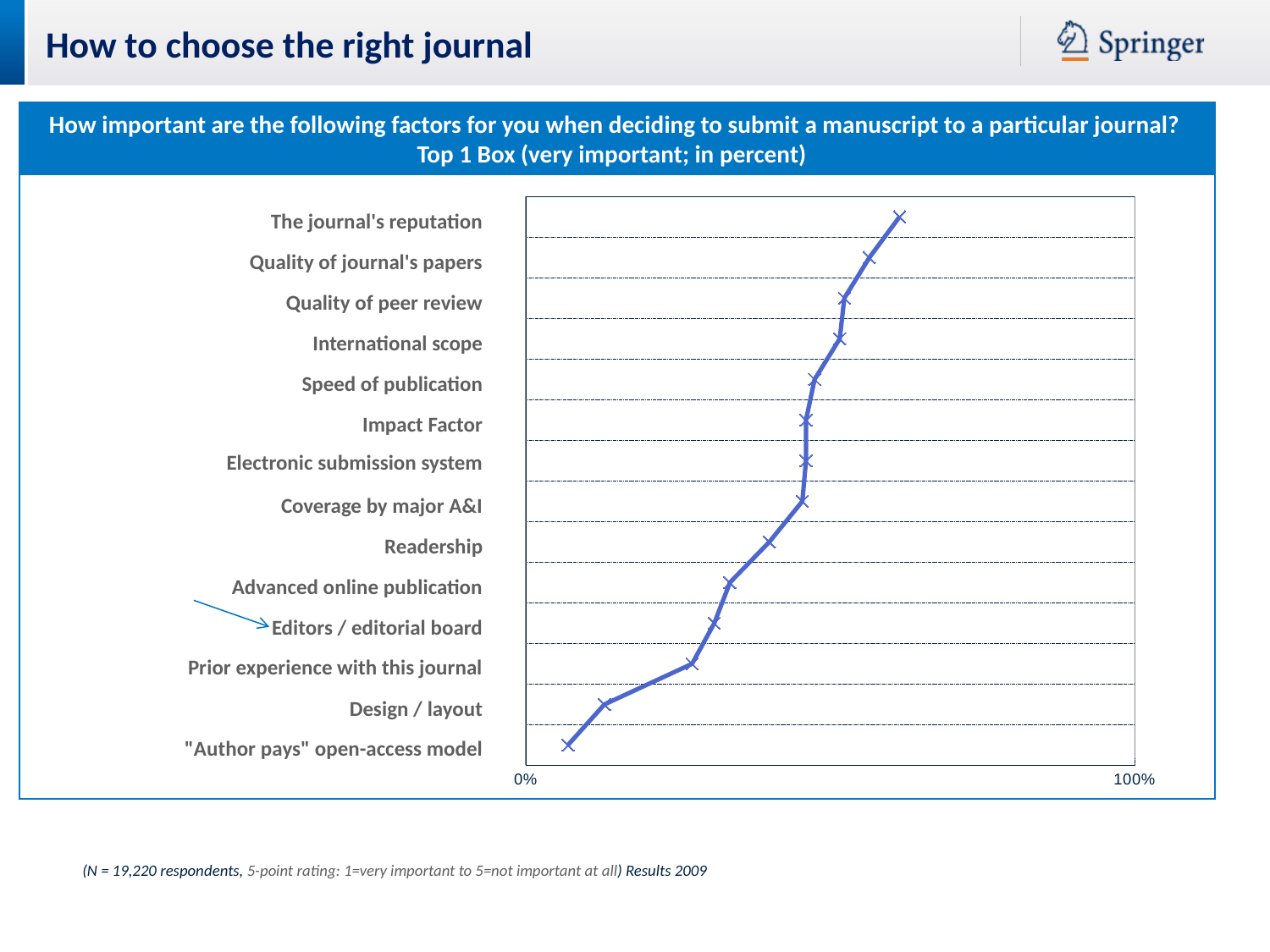
How many factors are listed on the chart? 14 What is the label at the right end of the horizontal axis? 100% Do the values rise or fall when reading the factors from top to bottom of the chart? fall Which has the larger value, Quality of peer review or Speed of publication? Quality of peer review Which factor has the highest value on the chart? The journal's reputation Which has the larger value, Readership or Design / layout? Readership What kind of chart is shown on the slide? line chart What is the second line of the chart's title? Top 1 Box (very important; in percent) Which factor has the lowest value on the chart? "Author pays" open-access model Which has the larger value, Prior experience with this journal or Quality of journal's papers? Quality of journal's papers